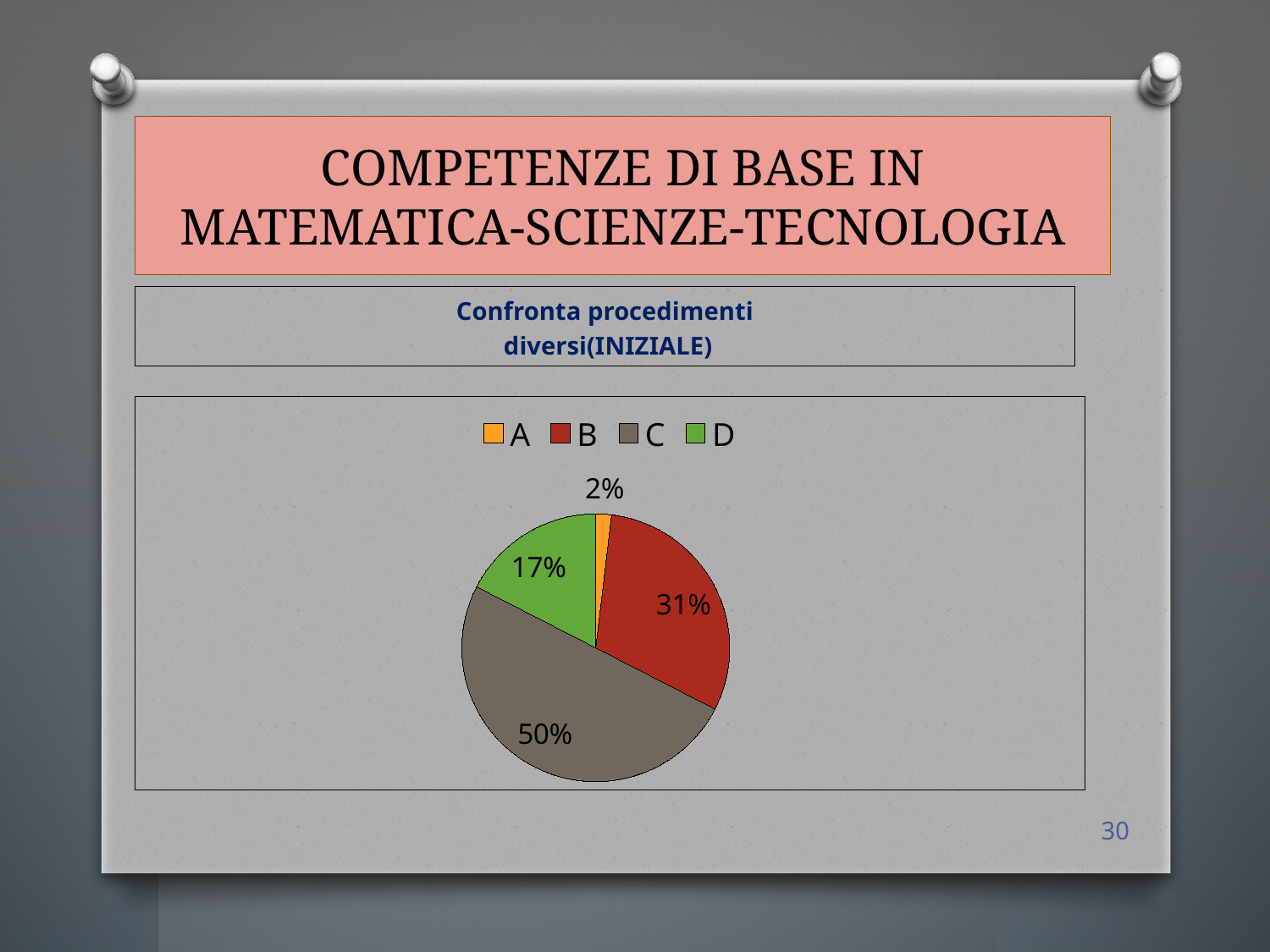
What percentage does slice C represent in the pie chart? 50% What colour is slice C in the pie chart? grey What is the difference in percentage points between slice D and slice A? 15 Which category has the largest slice of the pie chart? C What is the difference in percentage points between slice C and slice B? 19 What percentage does slice D represent in the pie chart? 17% Which slice is larger, B or D? B Which category has the smallest slice of the pie chart? A What percentage does slice A represent in the pie chart? 2% What percentage does slice B represent in the pie chart? 31% What kind of chart is shown on the slide? pie chart How many categories does the legend of the pie chart list? 4